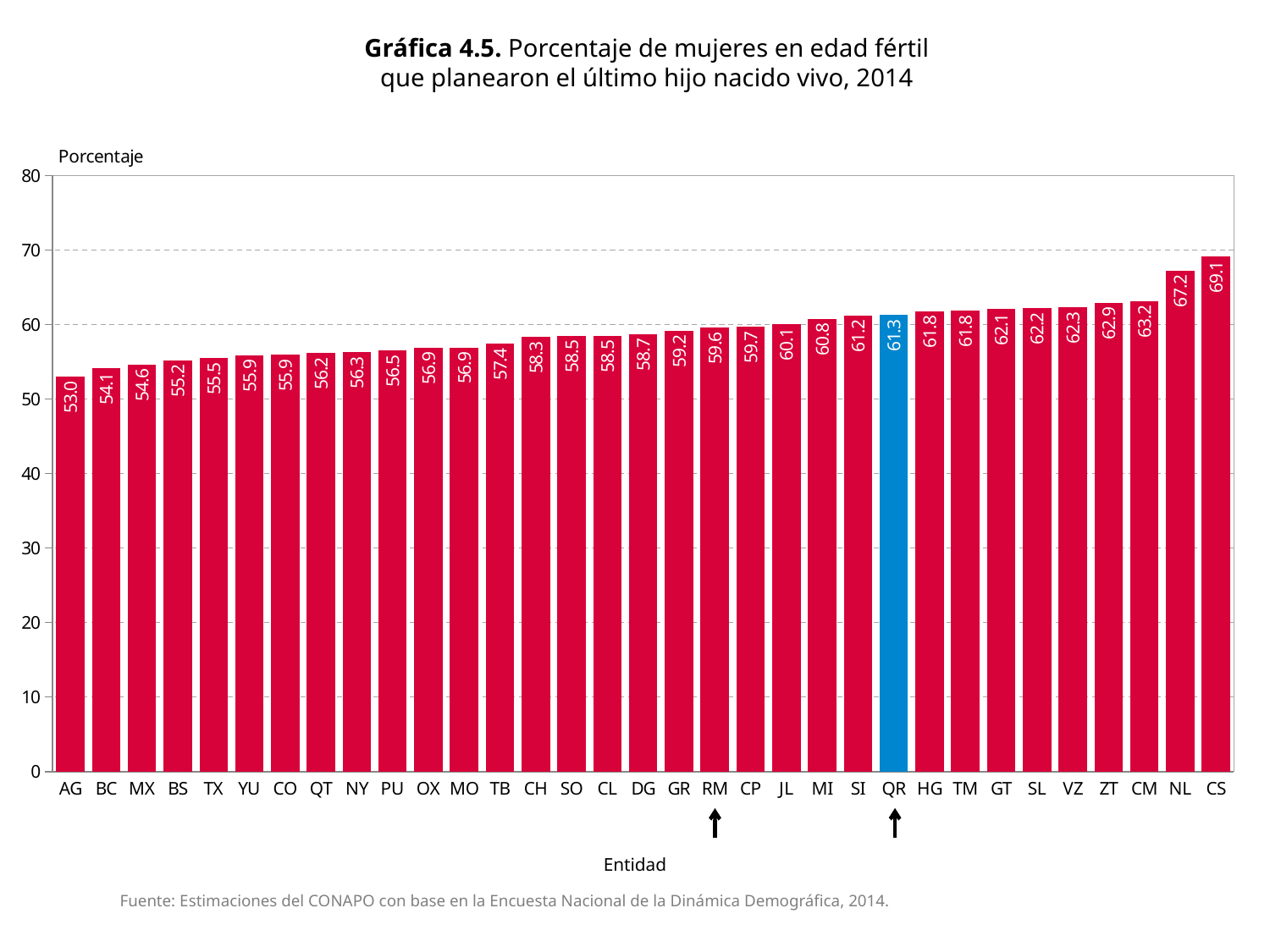
What is the difference between the values for CS and NL? 1.9 Is the value for NL greater or less than 60? greater What is the difference between the values for QR and AG? 8.3 How many entities are shown on the x axis? 33 Which entity has the lowest value? AG Which entity has the highest value? CS What kind of chart is this? bar chart Which bar is coloured blue instead of red? QR What is the value for RM? 59.6 What is the value for QR? 61.3 What is the value for AG? 53.0 Which is larger, the value for JL or the value for MI? MI